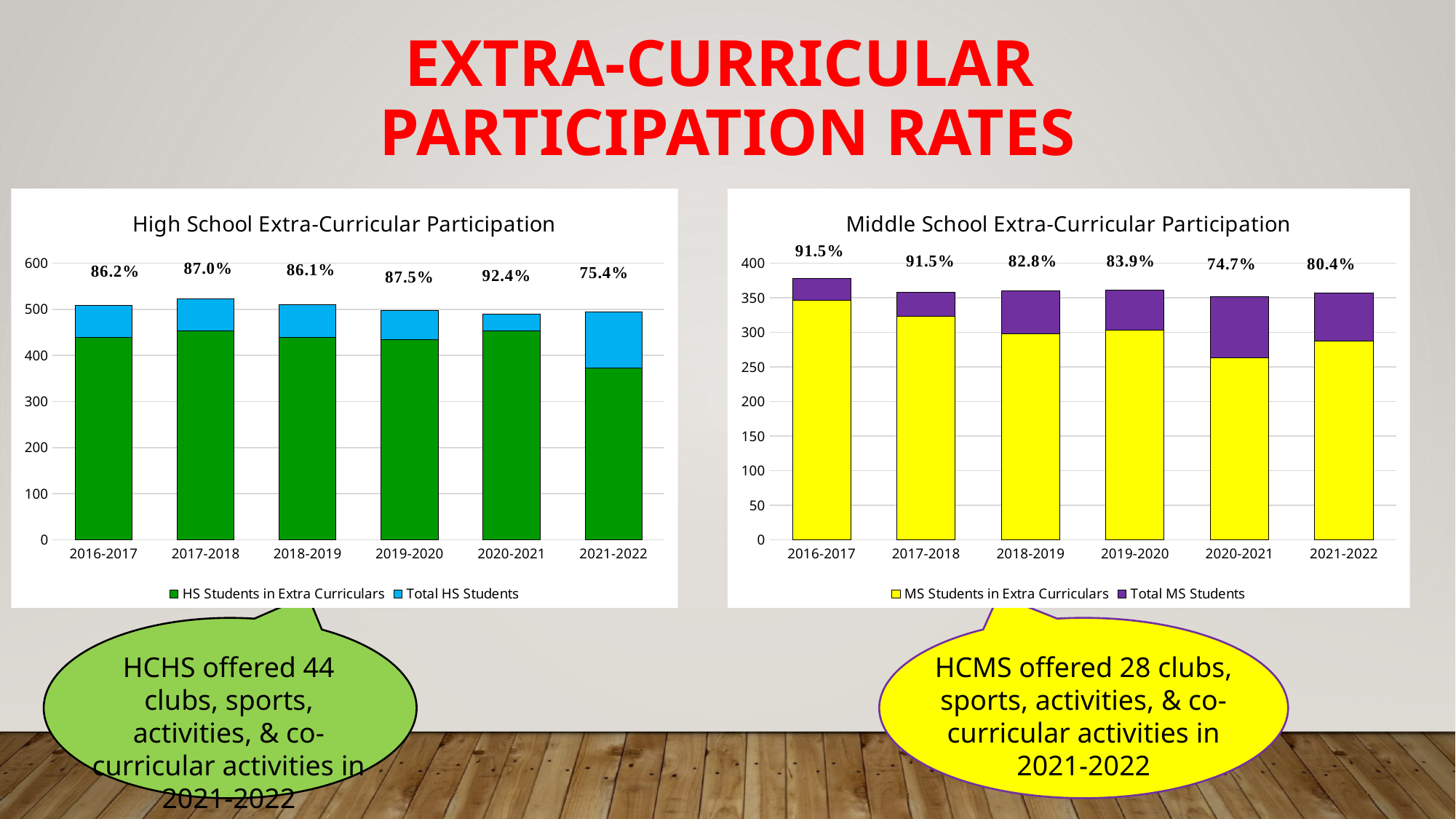
In the High School Extra-Curricular Participation chart, is the HS Students in Extra Curriculars value for 2021-2022 greater or less than 400? less In the High School Extra-Curricular Participation chart, which school year has the highest labelled participation rate? 2020-2021 In the High School Extra-Curricular Participation chart, what participation rate is labelled for 2020-2021? 92.4% In the Middle School Extra-Curricular Participation chart, which school year has the lowest labelled participation rate? 2020-2021 How many school years are shown on the x axis of the Middle School Extra-Curricular Participation chart? 6 What kind of chart is the Middle School Extra-Curricular Participation chart? Stacked bar chart In the High School Extra-Curricular Participation chart, what is the difference between the labelled rates for 2020-2021 and 2021-2022? 17.0% In the High School Extra-Curricular Participation chart, how many series does the legend list? 2 In the Middle School Extra-Curricular Participation chart, what participation rate is labelled for 2018-2019? 82.8% In the High School Extra-Curricular Participation chart, which school year has the lowest labelled participation rate? 2021-2022 In the Middle School Extra-Curricular Participation chart, is the MS Students in Extra Curriculars value for 2020-2021 greater or less than 300? less In the Middle School Extra-Curricular Participation chart, is the labelled rate for 2019-2020 larger or smaller than the rate for 2021-2022? larger